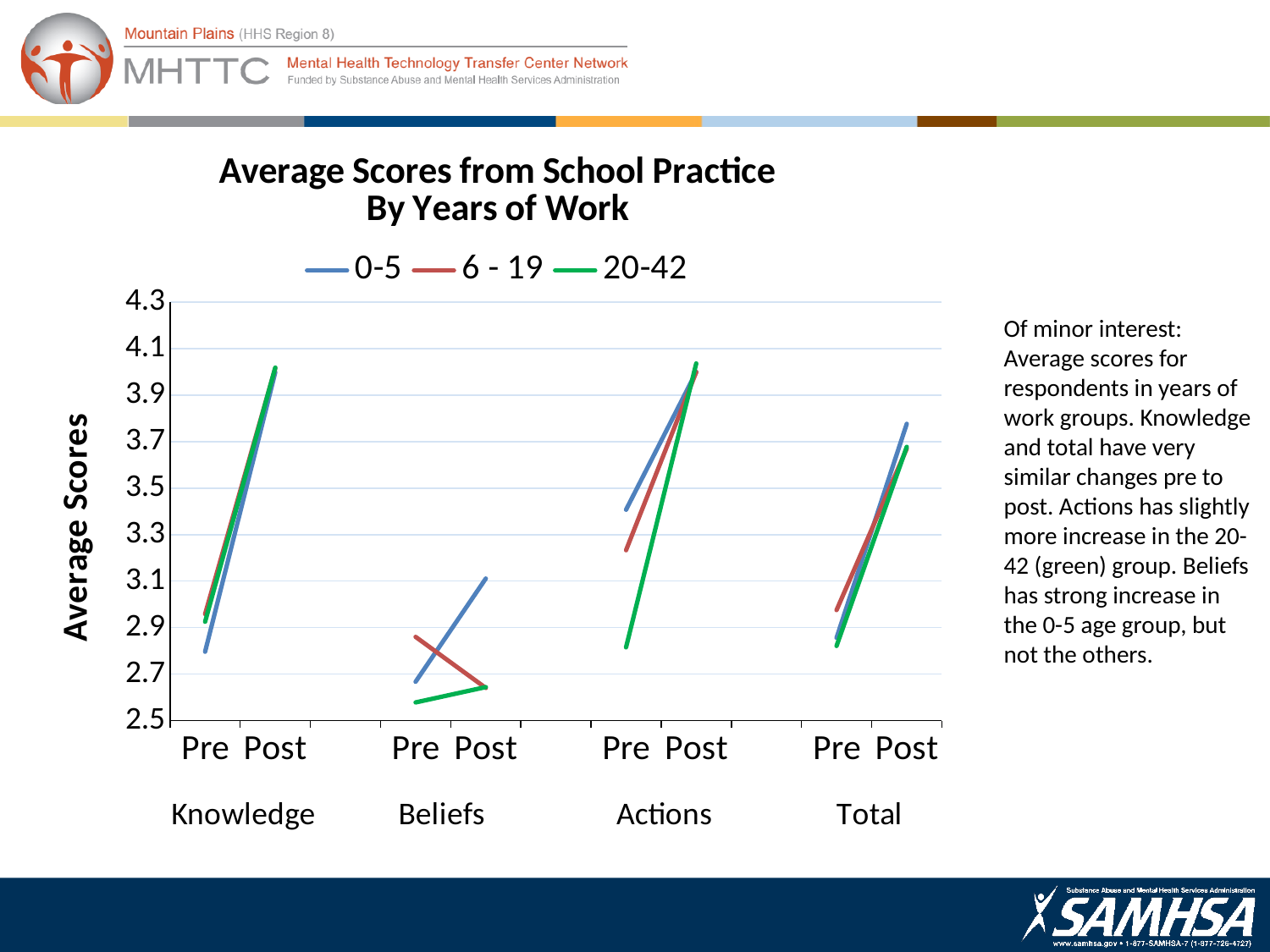
What is the label on the vertical axis? Average Scores What is the title of the chart? Average Scores from School Practice By Years of Work Is the Beliefs Pre value for the 20-42 group greater or less than 2.7? less What kind of chart is shown on the slide? line chart Is the Knowledge Pre value for the 0-5 group greater or less than 2.9? less Is the Actions Post value for the 20-42 group greater or less than 3.9? greater How many series does the legend list? 3 Which group has the lowest Beliefs Pre value? 20-42 Which group has the larger Actions Pre value, 0-5 or 20-42? 0-5 For the 6 - 19 group, does the Beliefs score rise or fall from Pre to Post? fall How many score categories (Knowledge, Beliefs, etc.) are shown along the x axis? 4